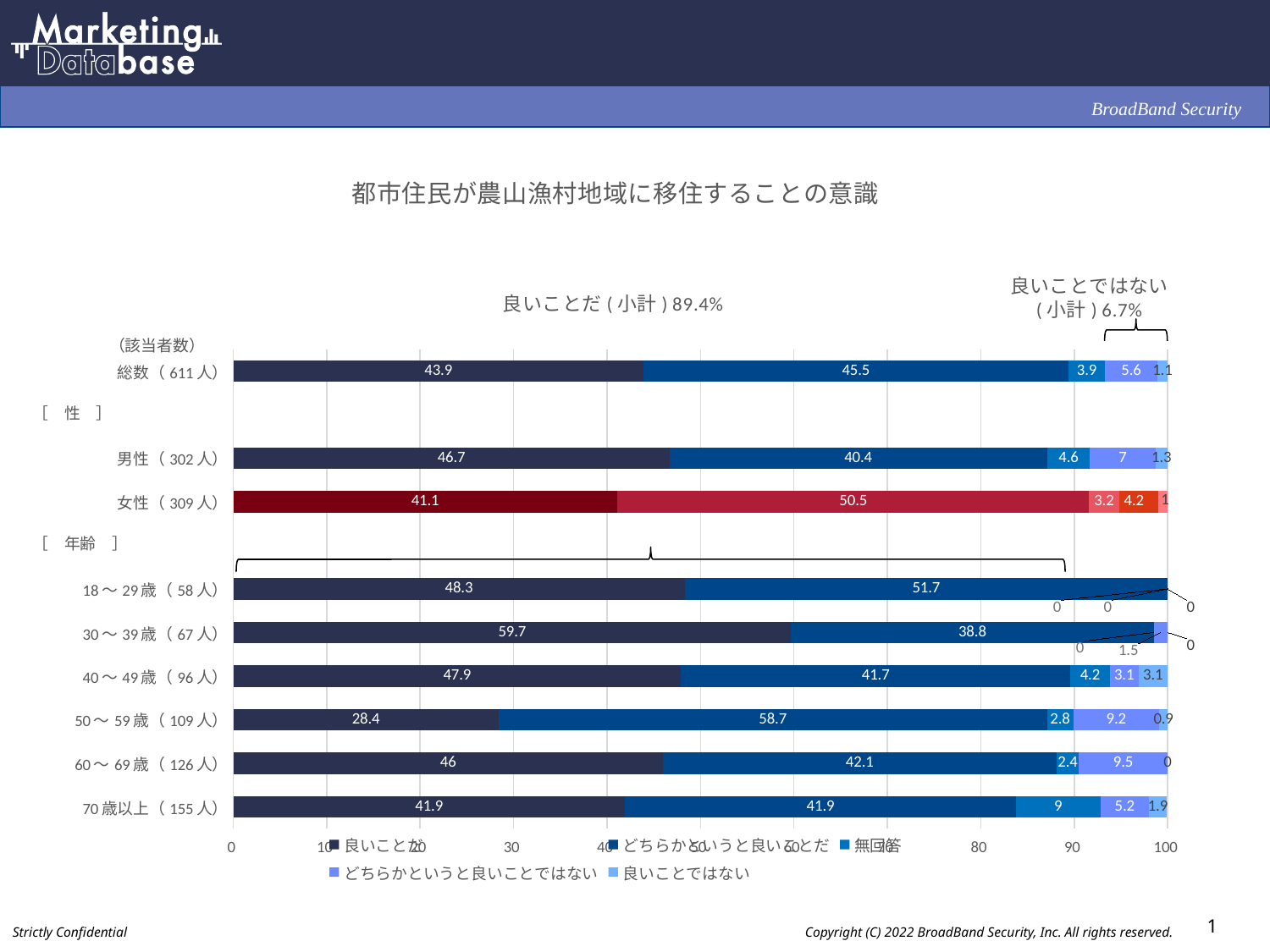
Which is larger, the どちらかというと良いことだ value for 18～29歳 (58人) or for 30～39歳 (67人)? 18～29歳 (58人) What is the difference between the 良いことだ values for 男性 (302人) and 女性 (309人)? 5.6 What is the value of どちらかというと良いことではない for 60～69歳 (126人)? 9.5 Which category has the lowest value for 良いことだ? 50～59歳 (109人) What is the value of どちらかというと良いことだ for 女性 (309人)? 50.5 How many series does the legend list? 5 Which category has the highest value for 良いことだ? 30～39歳 (67人) What type of chart is shown on the slide? Stacked bar chart What is the combined value of どちらかというと良いことではない and 良いことではない for 男性 (302人)? 8.3 What is the value of 良いことだ for 総数 (611人)? 43.9 What is the title of the chart? 都市住民が農山漁村地域に移住することの意識 How many category bars are plotted in the chart? 9